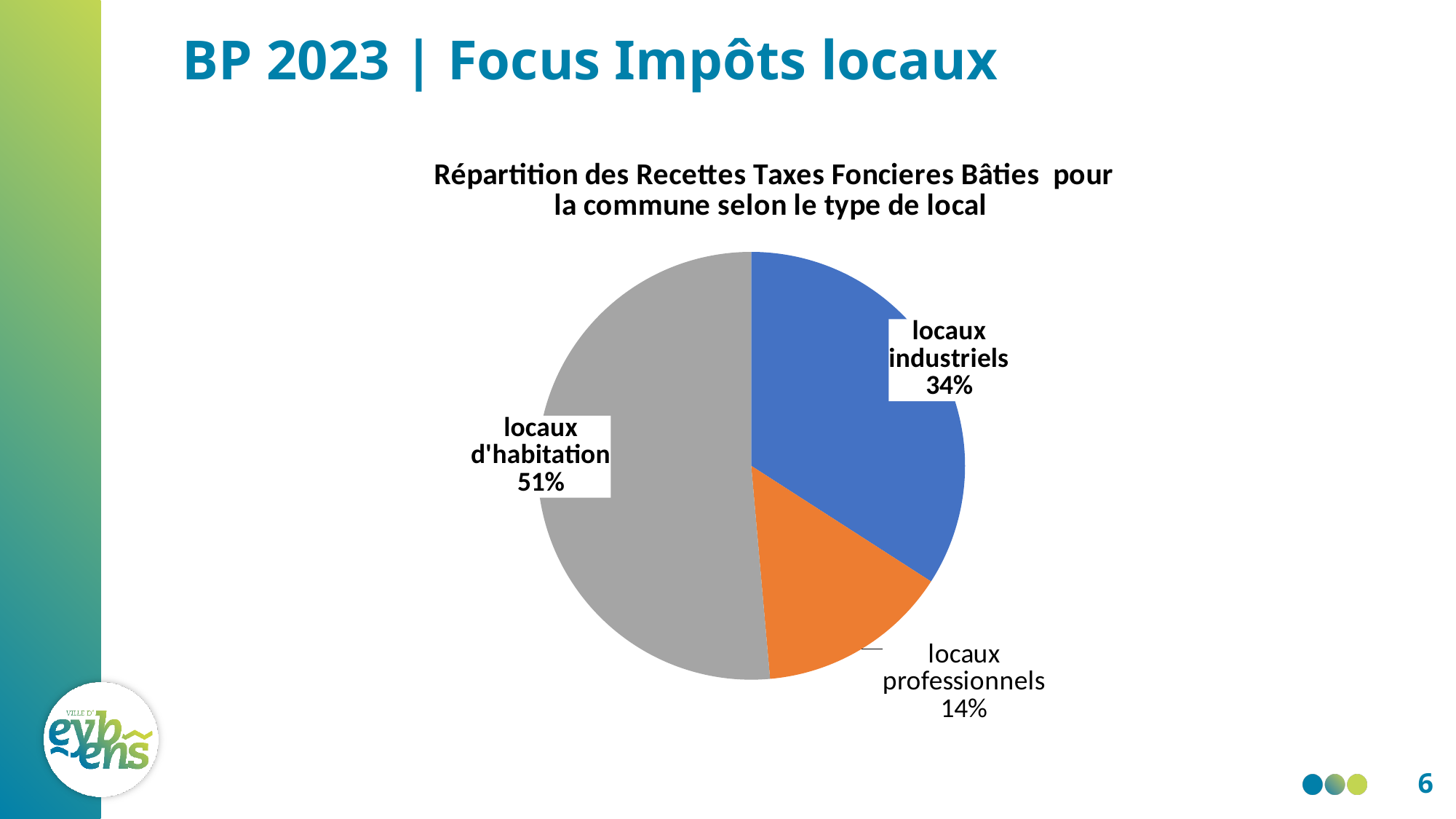
What kind of chart is shown on the slide? pie chart What colour is the slice for locaux professionnels? orange What share of the pie is taken by locaux industriels? 34% What is the title of the chart? Répartition des Recettes Taxes Foncieres Bâties pour la commune selon le type de local How many categories are shown in the pie chart? 3 Which category has the smallest share of the pie? locaux professionnels What share of the pie is taken by locaux professionnels? 14% Which is larger, the share for locaux industriels or for locaux professionnels? locaux industriels What is the difference in percentage points between locaux industriels and locaux professionnels? 20 What share of the pie is taken by locaux d'habitation? 51% Which category has the largest share of the pie? locaux d'habitation What is the difference in percentage points between locaux d'habitation and locaux industriels? 17